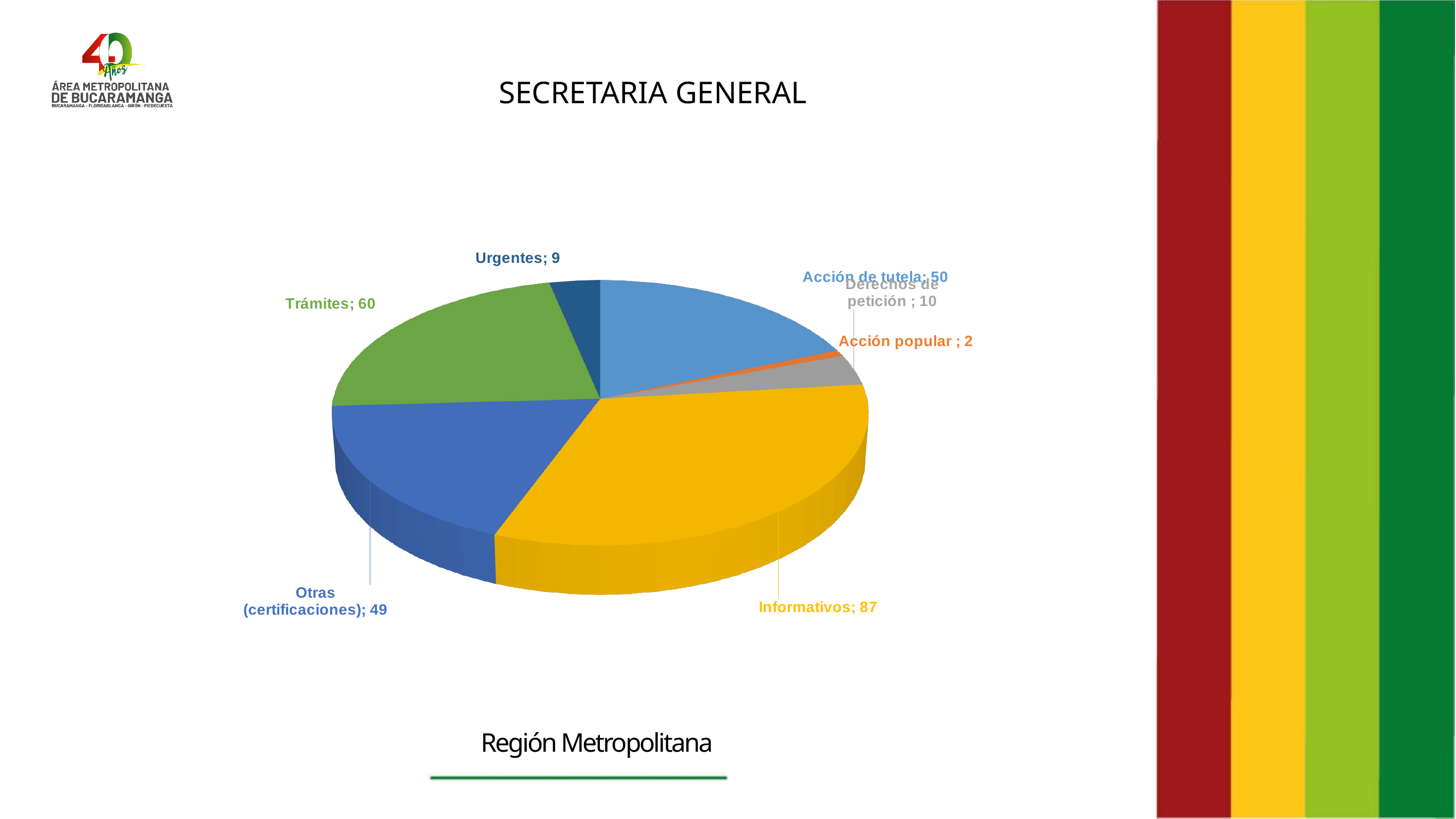
How many categories are shown in the pie chart? 7 What is the value for Trámites? 60 What is the value for Informativos? 87 What is the difference between the values for Informativos and Trámites? 27 What is the value for Otras (certificaciones)? 49 What is the value for Derechos de petición? 10 What is the value for Acción de tutela? 50 What is the title shown above the chart? SECRETARIA GENERAL Which category has the smallest slice of the pie? Acción popular What kind of chart is shown on the slide? Pie chart Which is larger, the value for Trámites or the value for Acción de tutela? Trámites Which category has the largest slice of the pie? Informativos